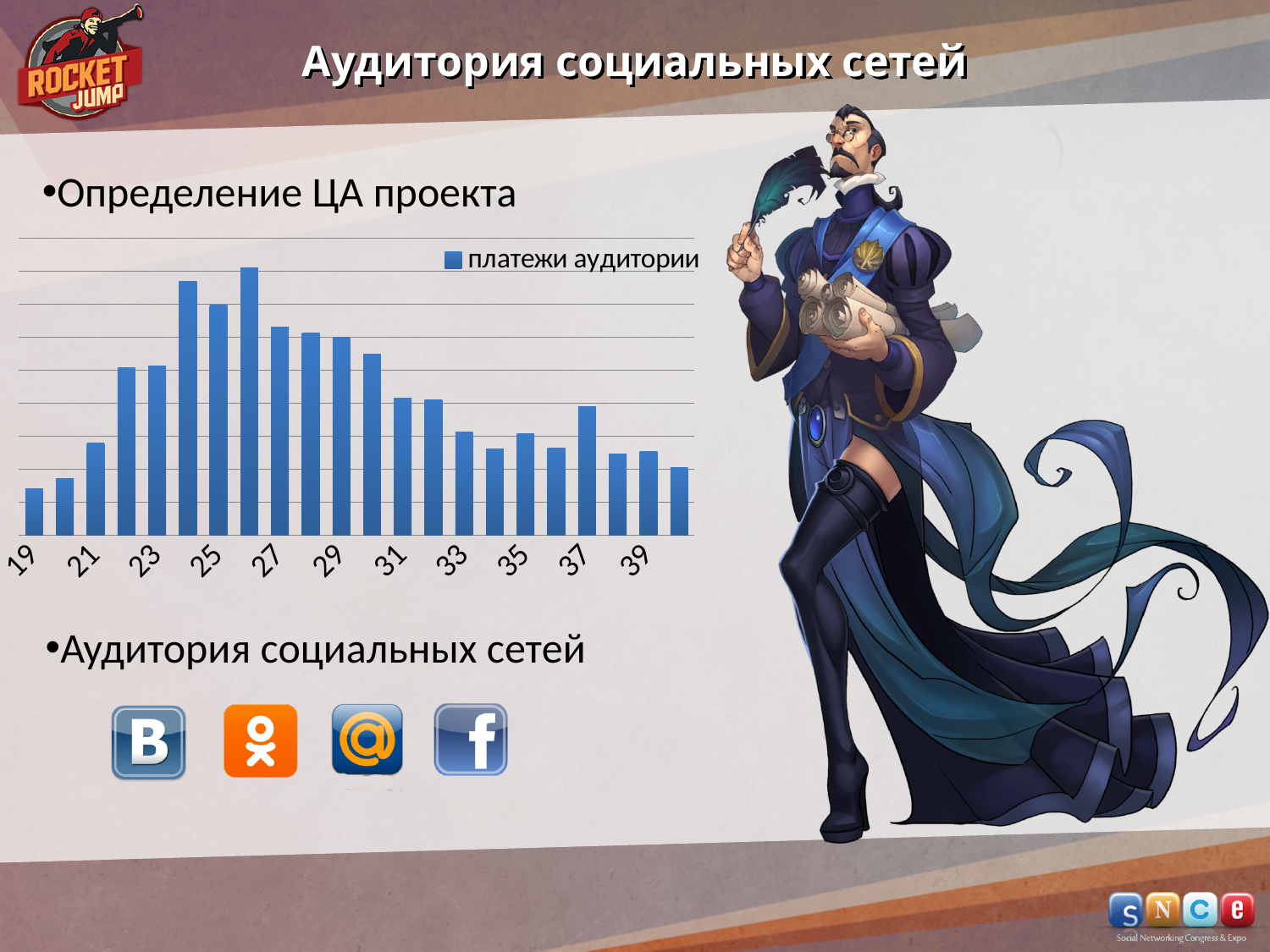
What kind of chart is shown on the slide? bar chart Which has the larger value, category 19 or category 26? 26 Which category has the highest value in the chart? 26 Do the values rise or fall along the x axis from category 19 to category 23? rise How many series does the chart legend list? 1 Do the values rise or fall along the x axis from category 26 to category 33? fall Which has the larger value, category 37 or category 36? 37 What is the name of the series shown in the chart legend? платежи аудитории Which category has the lowest value in the chart? 19 Which has the larger value, category 25 or category 27? 25 How many bars are plotted in the chart? 22